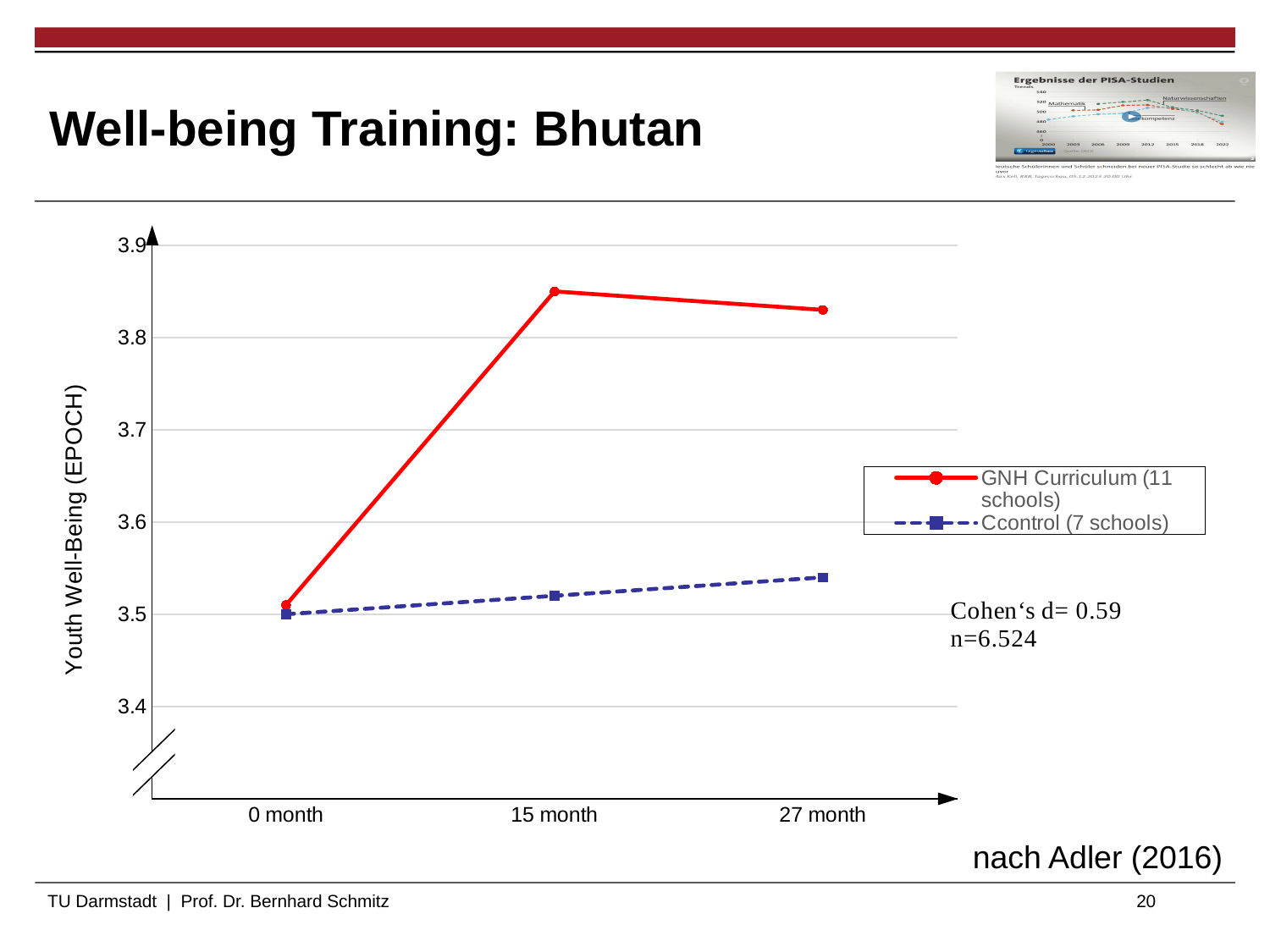
Is the value for GNH Curriculum (11 schools) at 0 month greater or less than 3.6? less What kind of chart is shown on the slide? line chart At 15 month, which series has the higher value, GNH Curriculum (11 schools) or Ccontrol (7 schools)? GNH Curriculum (11 schools) Is the value for GNH Curriculum (11 schools) at 15 month greater or less than 3.8? greater At which time point is the GNH Curriculum (11 schools) series lowest? 0 month Is the value for Ccontrol (7 schools) at 27 month greater or less than 3.6? less What is the label of the y axis? Youth Well-Being (EPOCH) What Cohen's d value is printed next to the chart? 0.59 Does the Ccontrol (7 schools) series rise or fall from 0 month to 27 month? rise How many time points are plotted along the x axis? 3 How many series does the legend list? 2 At which time point does the GNH Curriculum (11 schools) series reach its highest value? 15 month